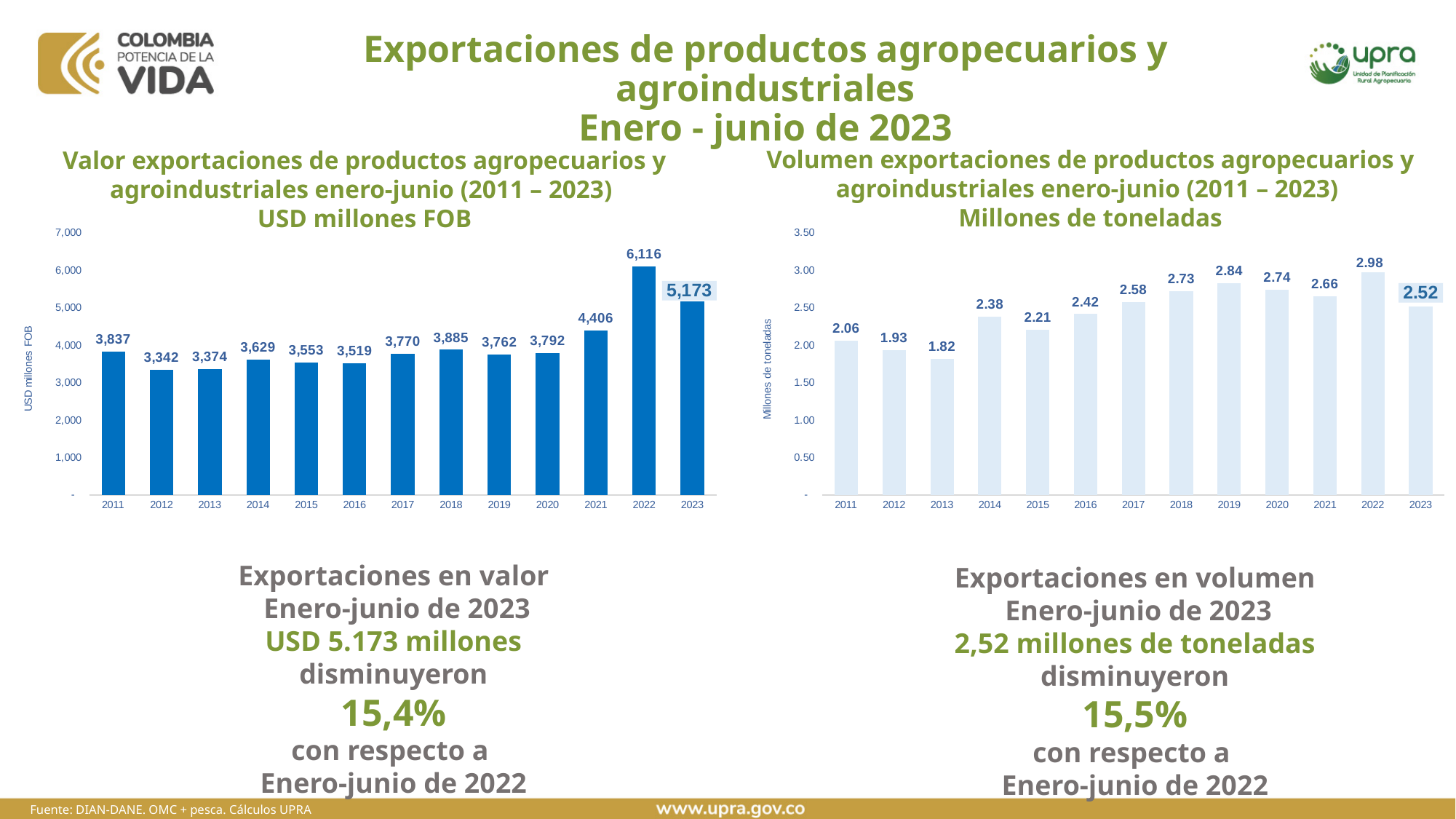
What type of chart is the left chart (Valor exportaciones, USD millones FOB)? Bar chart In the left chart (Valor exportaciones, USD millones FOB), is the value for 2021 greater or less than 4,000? greater In the left chart (Valor exportaciones, USD millones FOB), how many years are plotted? 13 In the left chart (Valor exportaciones, USD millones FOB), which year has the lowest value? 2012 In the right chart (Volumen exportaciones, Millones de toneladas), which year has the highest value? 2022 In the left chart (Valor exportaciones, USD millones FOB), which year has the highest value? 2022 In the left chart (Valor exportaciones, USD millones FOB), what is the difference between the 2022 and 2023 values? 943 In the right chart (Volumen exportaciones, Millones de toneladas), which year has the lowest value? 2013 In the right chart (Volumen exportaciones, Millones de toneladas), which is larger, the value for 2014 or the value for 2015? 2014 In the right chart (Volumen exportaciones, Millones de toneladas), what is the value for 2019? 2.84 In the right chart (Volumen exportaciones, Millones de toneladas), what is the difference between the 2022 and 2023 values? 0.46 In the left chart (Valor exportaciones, USD millones FOB), what is the value for 2023? 5,173